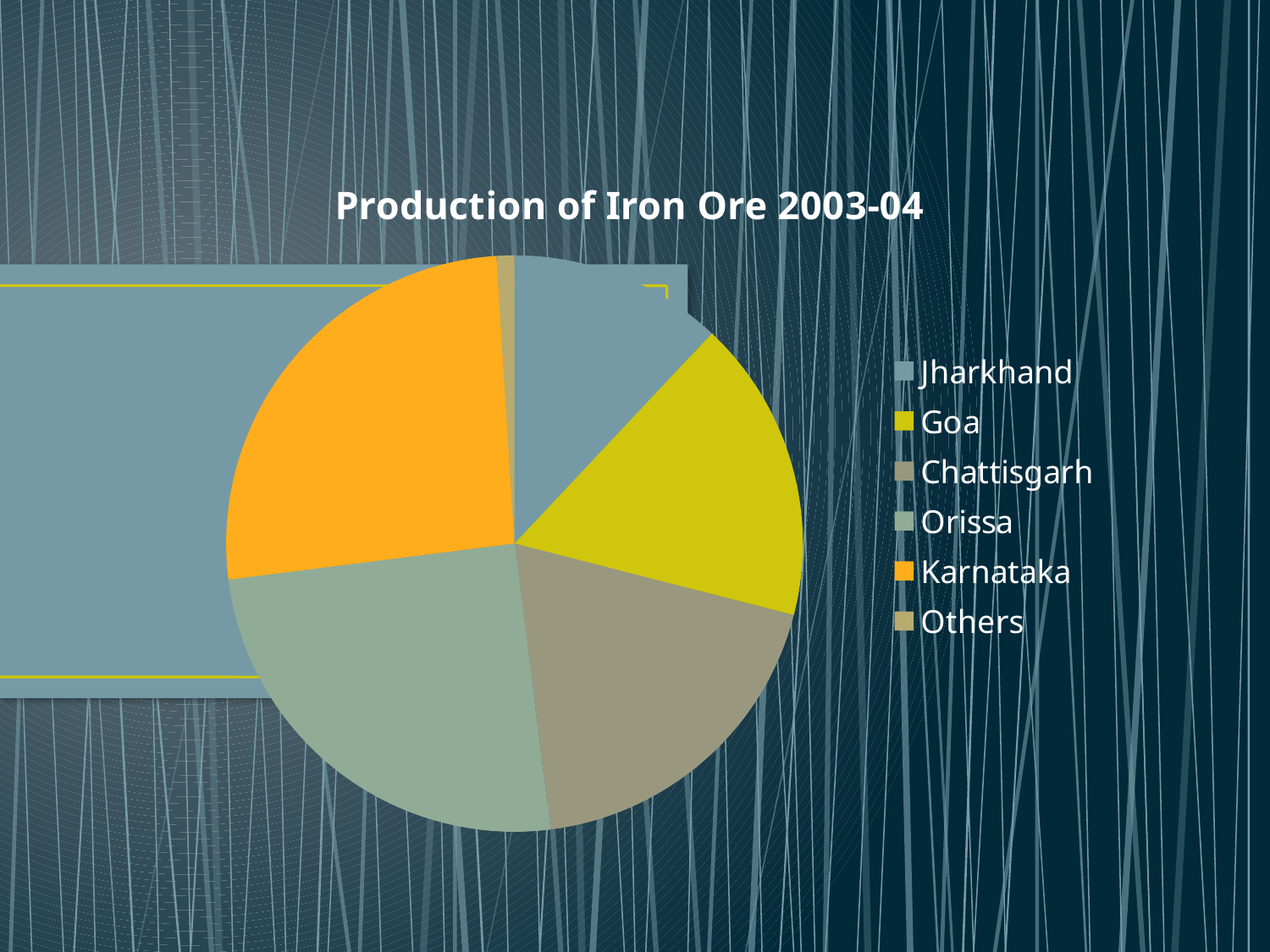
Which slice is larger, Goa or Jharkhand? Goa Which colour represents Karnataka in the pie chart? Orange What is the title of the chart? Production of Iron Ore 2003-04 Which category is listed first in the legend? Jharkhand Which category has the smallest slice of the pie? Others Which slice is larger, Karnataka or Chattisgarh? Karnataka What kind of chart is shown on the slide? Pie chart Which slice is larger, Jharkhand or Others? Jharkhand How many entries does the legend list? 6 How many categories (slices) does the pie chart have? 6